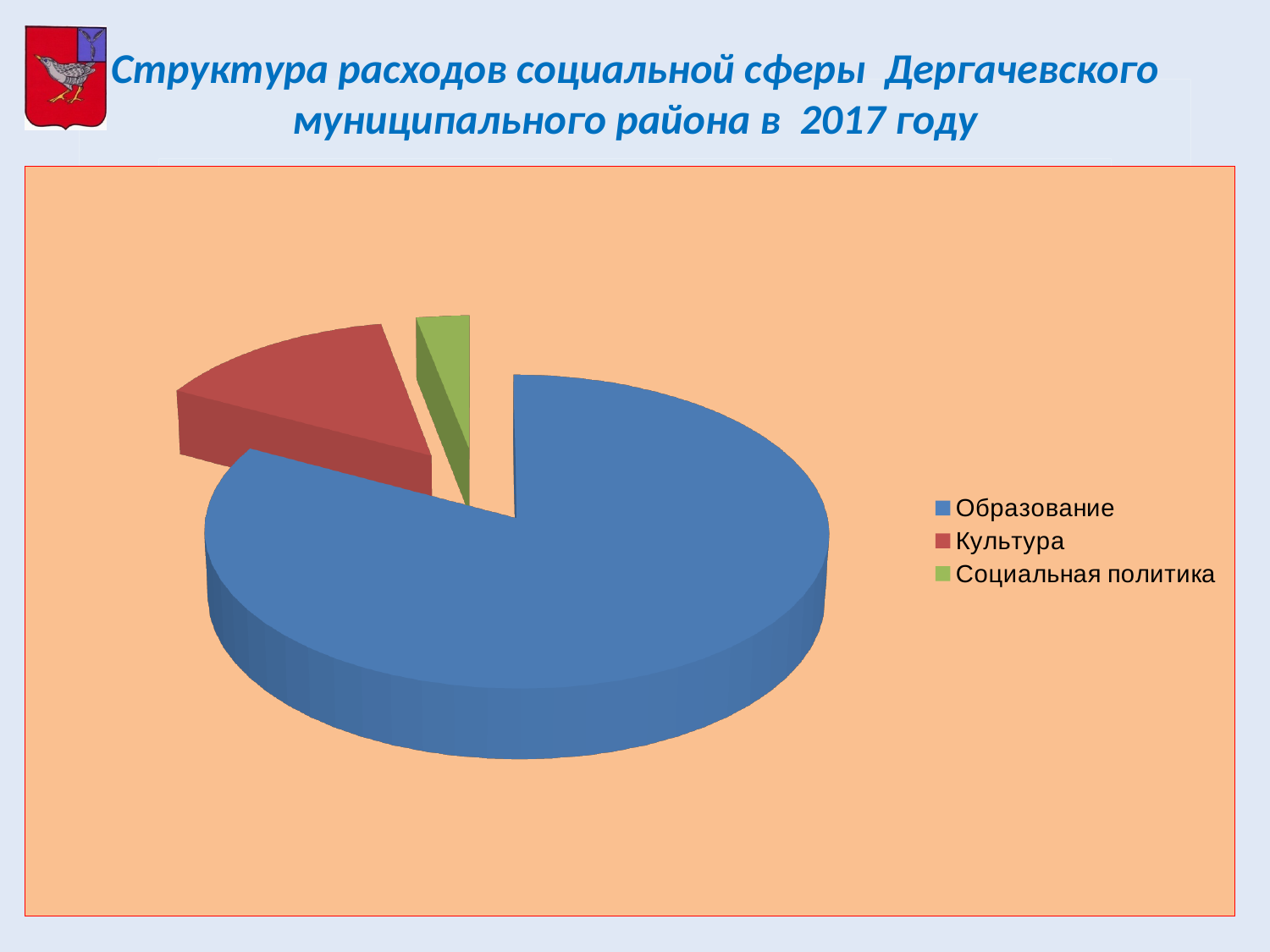
Which category has the smallest share of the pie? Социальная политика Which is larger, the slice for Культура or the slice for Социальная политика? Культура Does Образование account for more or less than half of the pie? more Which category has the largest share of the pie? Образование How many entries does the legend list? 3 Which is larger, the slice for Образование or the slice for Культура? Образование How many slices does the pie chart have? 3 What colour is the slice for Культура? red What kind of chart is shown on the slide? pie chart Which category is shown in green in the legend? Социальная политика